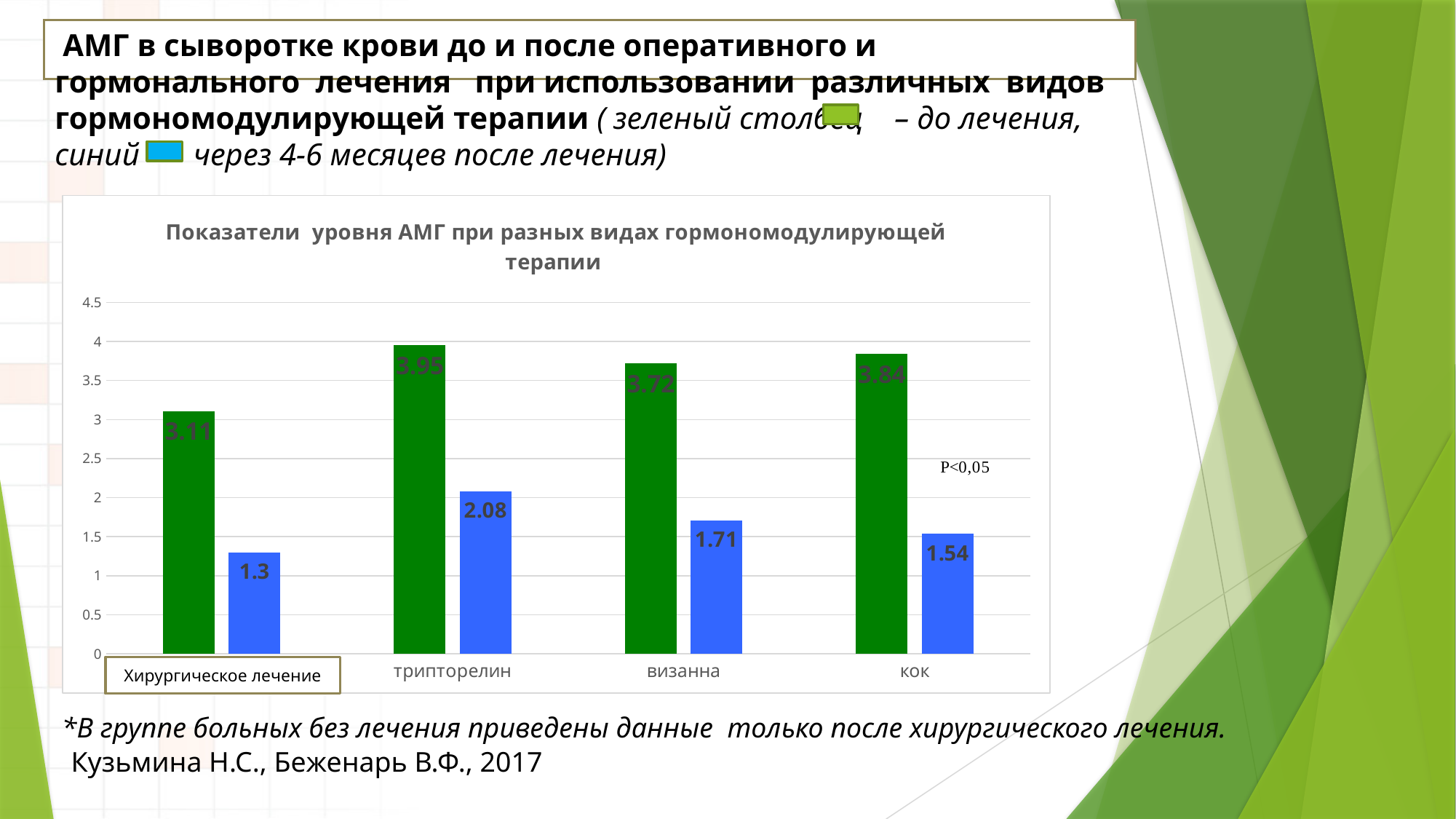
Which is larger: the blue value for визанна or the blue value for кок? визанна What is the blue (after treatment) AMH value for визанна? 1.71 What is the green (before treatment) AMH value for кок? 3.84 Do the blue (after treatment) values rise or fall from визанна to кок? fall How many categories are shown on the x axis? 4 Which category has the lowest blue (after treatment) value? Хирургическое лечение What is the title of the chart? Показатели уровня АМГ при разных видах гормономодулирующей терапии What type of chart is shown on the slide? bar chart What is the blue (after treatment) AMH value for Хирургическое лечение? 1.3 What is the difference between the green and blue values for трипторелин? 1.87 What is the green (before treatment) AMH value for трипторелин? 3.95 Which category has the highest green (before treatment) value? трипторелин